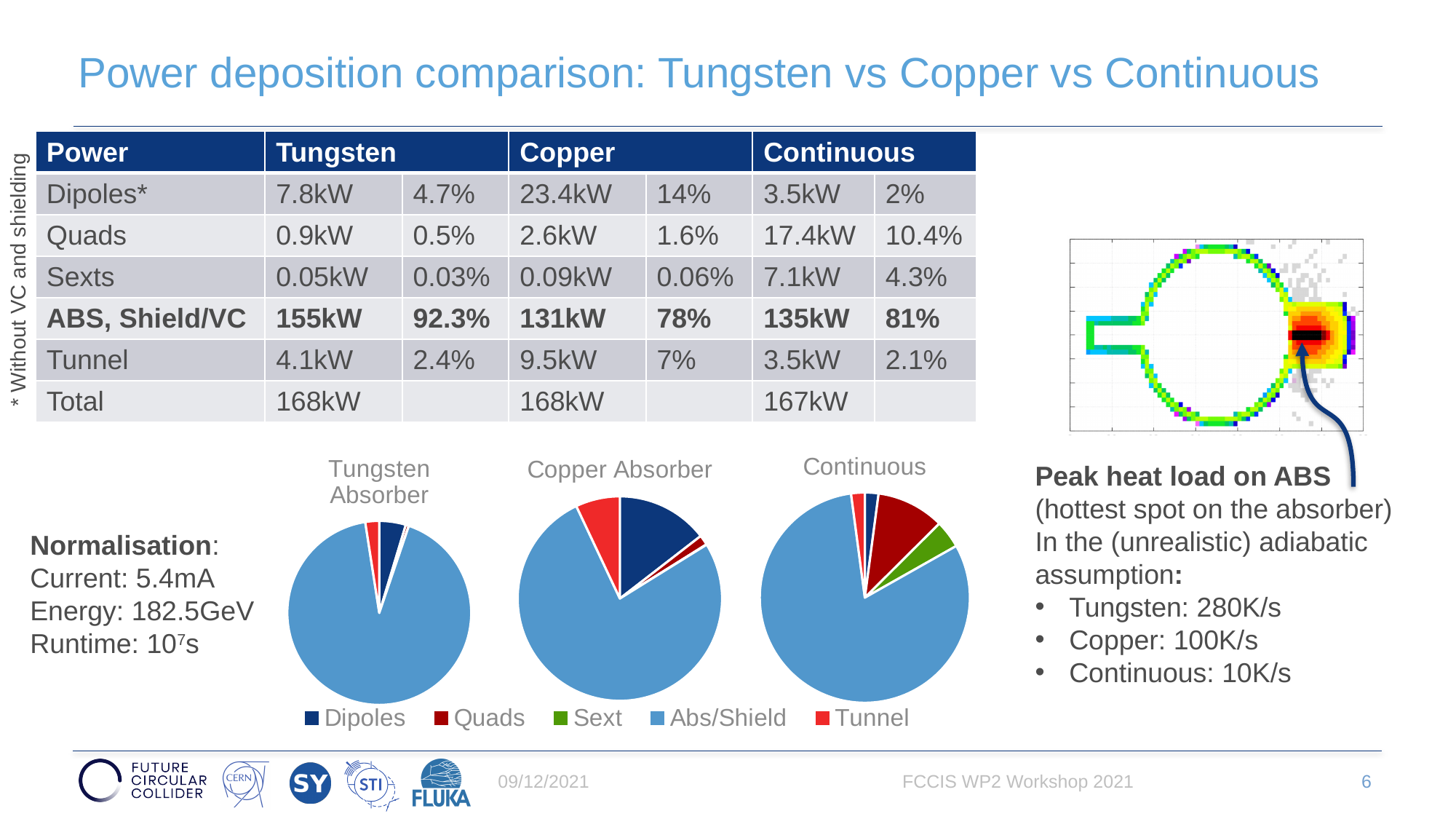
What colour is used for the Abs/Shield series in the pie charts? Light blue In the Copper Absorber pie chart, which slice is larger, Dipoles or Tunnel? Dipoles In the Tungsten Absorber pie chart, what share of the total does the Abs/Shield slice represent, according to the table on the slide? 92.3% In the Copper Absorber pie chart, what share of the total does the Dipoles slice represent, according to the table on the slide? 14% In the Continuous pie chart, which category has the largest slice? Abs/Shield What kind of chart is used to show the power deposition breakdown for Tungsten Absorber, Copper Absorber and Continuous? Pie chart What is the title of the rightmost pie chart? Continuous How many pie charts are shown on the slide? 3 How many series does the legend below the pie charts list? 5 In the Continuous pie chart, which slice is larger, Quads or Sext? Quads Is the Dipoles slice larger in the Copper Absorber pie chart or in the Tungsten Absorber pie chart? Copper Absorber In the Tungsten Absorber pie chart, which category has the largest slice? Abs/Shield